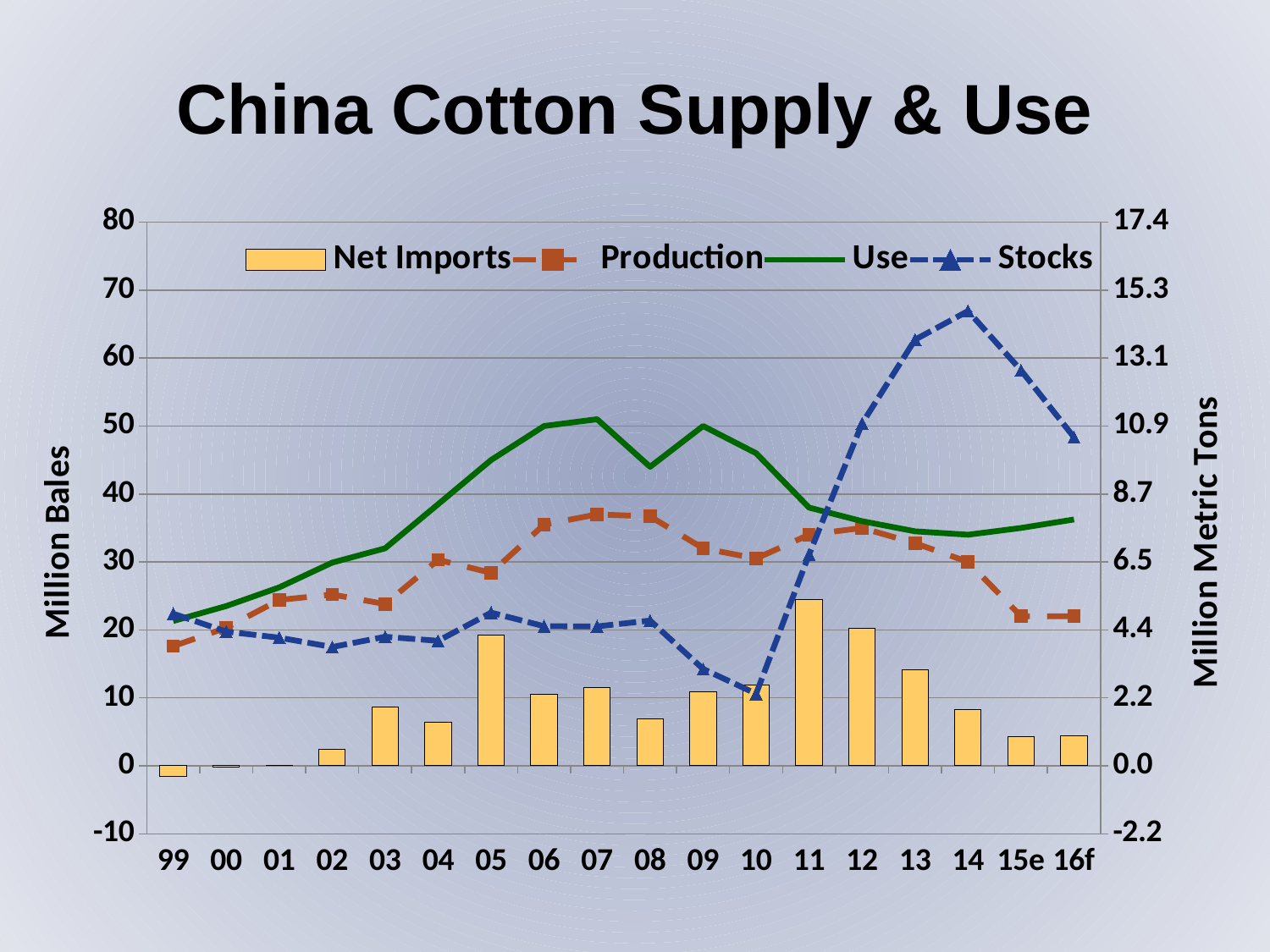
Is the value for Stocks in 14 greater or less than 13.1 million metric tons? greater In which year are Net Imports highest? 11 What kind of chart is this? Combined bar and line chart Is the value for Production in 16f greater or less than 30 million bales? less Is the value for Net Imports in 11 greater or less than 20 million bales? greater How many series does the legend list? 4 In which year do Stocks reach their highest point? 14 How many years are shown along the x axis? 18 Which is larger in 07, Use or Production? Use In which year are Net Imports lowest? 99 Do Stocks rise or fall from 10 to 14? rise What is the title of the chart? China Cotton Supply & Use